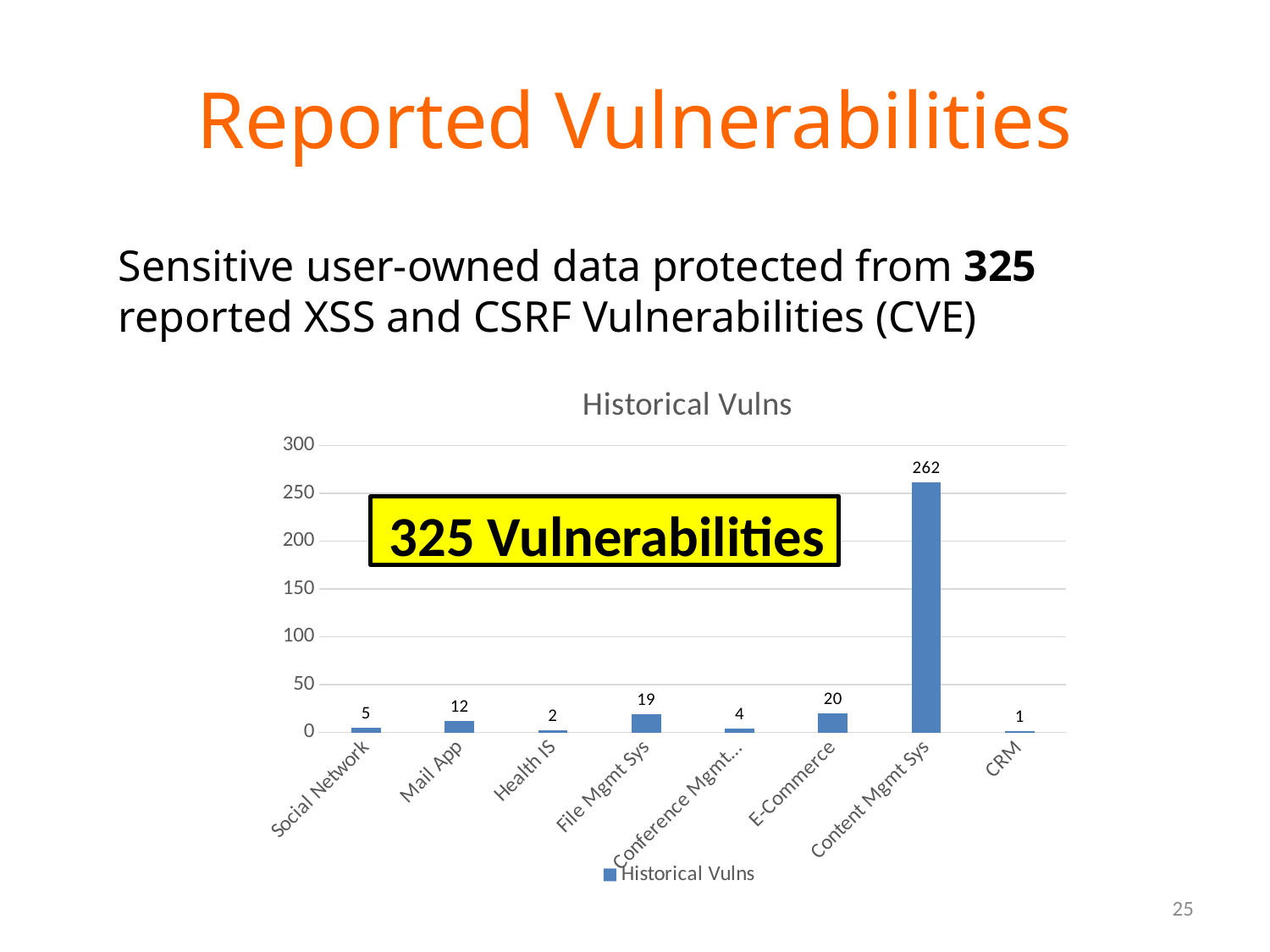
Which has a larger value in the Historical Vulns chart, Mail App or Social Network? Mail App How many series does the legend of the Historical Vulns chart list? 1 Which category has the lowest value in the Historical Vulns chart? CRM What is the difference between the values for Content Mgmt Sys and E-Commerce in the Historical Vulns chart? 242 How many categories are shown on the x axis of the Historical Vulns chart? 8 What is the value for E-Commerce in the Historical Vulns chart? 20 Which category has the highest value in the Historical Vulns chart? Content Mgmt Sys Is the value for Content Mgmt Sys in the Historical Vulns chart greater or less than 250? greater What kind of chart is the Historical Vulns chart? Bar chart What is the value for Mail App in the Historical Vulns chart? 12 What is the value for Health IS in the Historical Vulns chart? 2 What is the value for Content Mgmt Sys in the Historical Vulns chart? 262